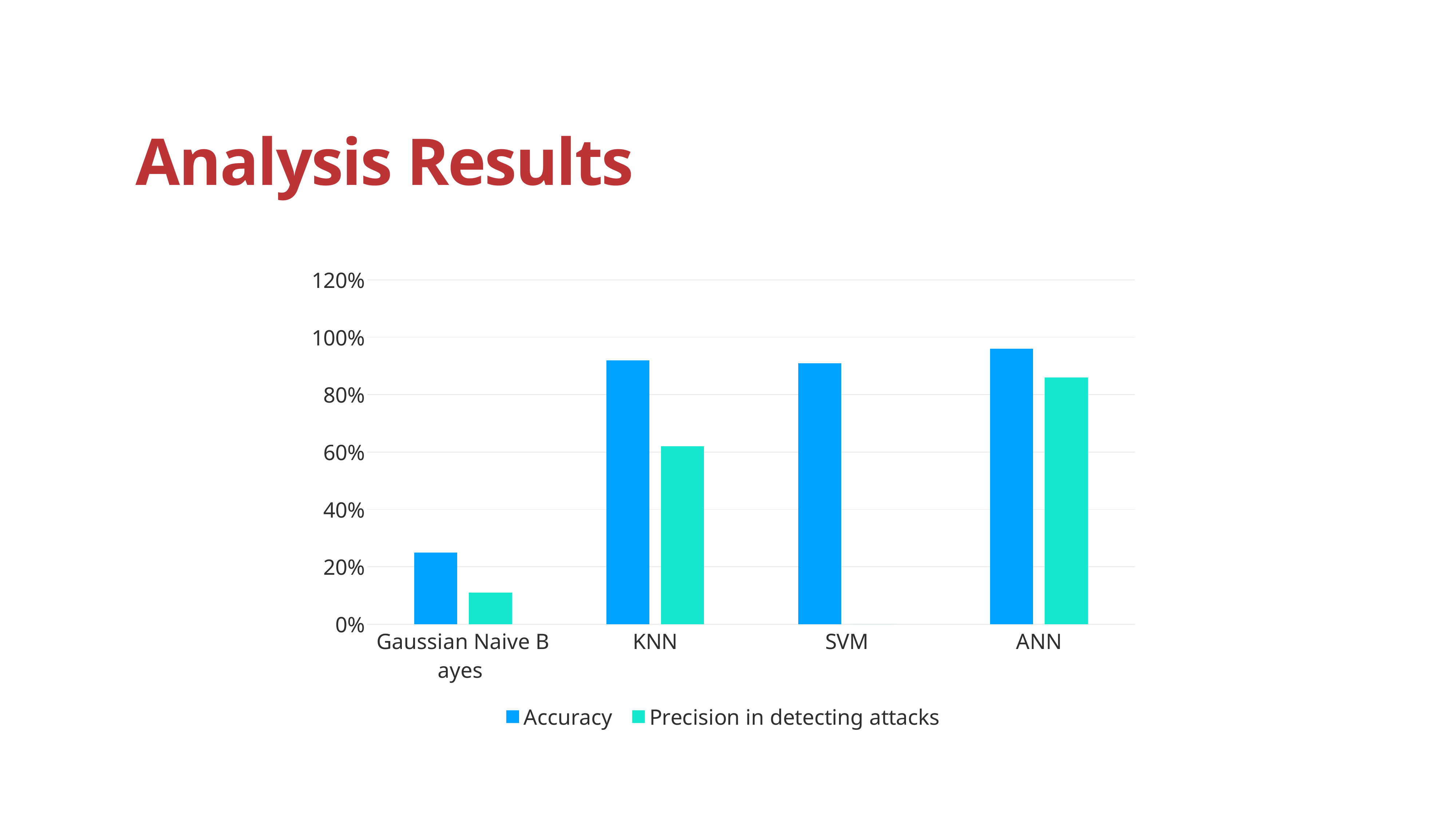
Which classifier has the lowest Accuracy? Gaussian Naive Bayes How many series does the legend list? 2 For KNN, which is larger: Accuracy or Precision in detecting attacks? Accuracy What kind of chart is shown on the slide? bar chart Which classifier has the highest Precision in detecting attacks? ANN Is the Precision in detecting attacks value for KNN greater or less than 40%? greater What is the title of the slide containing the chart? Analysis Results How many categories (classifiers) are shown on the x axis? 4 Is the Accuracy value for Gaussian Naive Bayes greater or less than 40%? less Is the Accuracy value for SVM greater or less than 80%? greater What are the two series named in the legend? Accuracy; Precision in detecting attacks